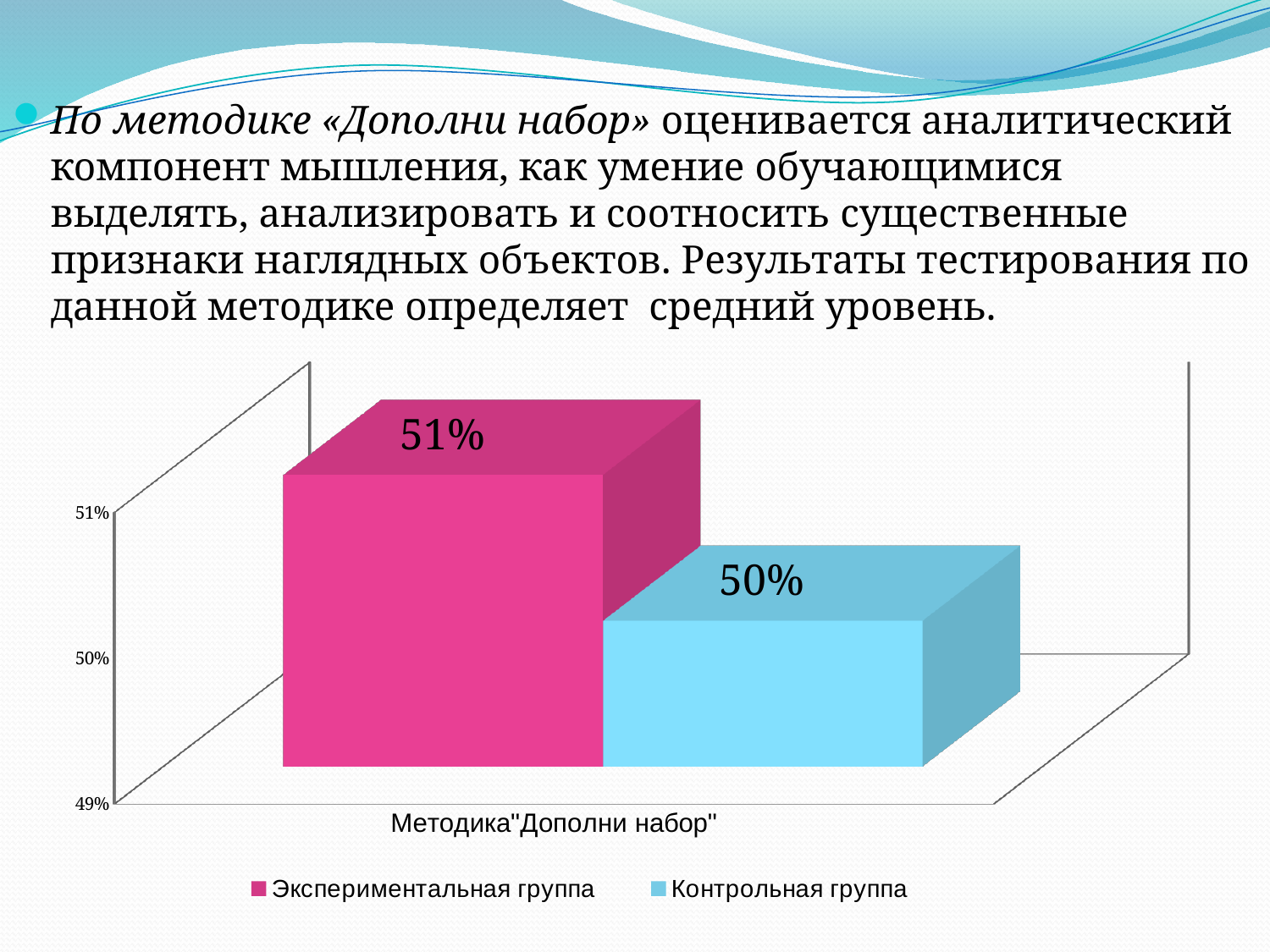
Which series has the lower value? Контрольная группа Which series has the higher value? Экспериментальная группа What colour is the bar for Контрольная группа? light blue What value is shown for the Контрольная группа series? 50% What is the category label on the x axis? Методика"Дополни набор" Is the value for Экспериментальная группа larger or smaller than the value for Контрольная группа? larger What kind of chart is shown on the slide? bar chart What is the difference between the Экспериментальная группа and Контрольная группа values? 1% What value is shown for the Экспериментальная группа series? 51% How many categories are shown on the x axis? 1 How many series does the legend list? 2